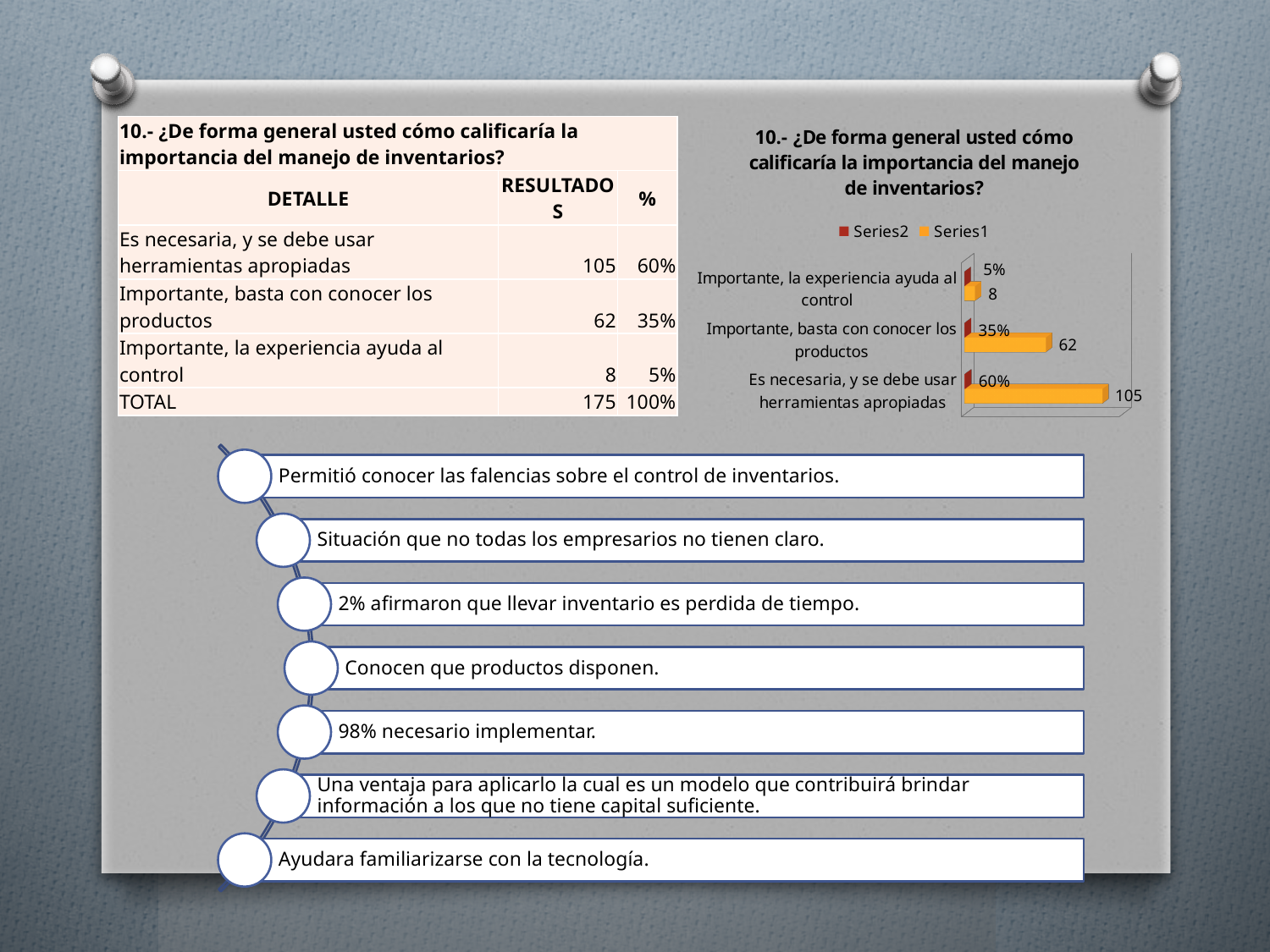
Which is larger: the Series1 value for "Importante, basta con conocer los productos" or for "Importante, la experiencia ayuda al control"? Importante, basta con conocer los productos How many categories are plotted in the chart? 3 What is the difference between the Series1 values for "Es necesaria, y se debe usar herramientas apropiadas" and "Importante, basta con conocer los productos"? 43 What is the Series1 value for "Importante, la experiencia ayuda al control"? 8 What is the Series1 value for "Es necesaria, y se debe usar herramientas apropiadas"? 105 What is the Series2 value for "Importante, basta con conocer los productos"? 35% How many series does the chart legend list? 2 Which category has the highest Series1 value? Es necesaria, y se debe usar herramientas apropiadas What is the Series2 value for "Es necesaria, y se debe usar herramientas apropiadas"? 60% What kind of chart is shown on the slide? bar chart What is the Series1 value for "Importante, basta con conocer los productos"? 62 Which category has the lowest Series1 value? Importante, la experiencia ayuda al control